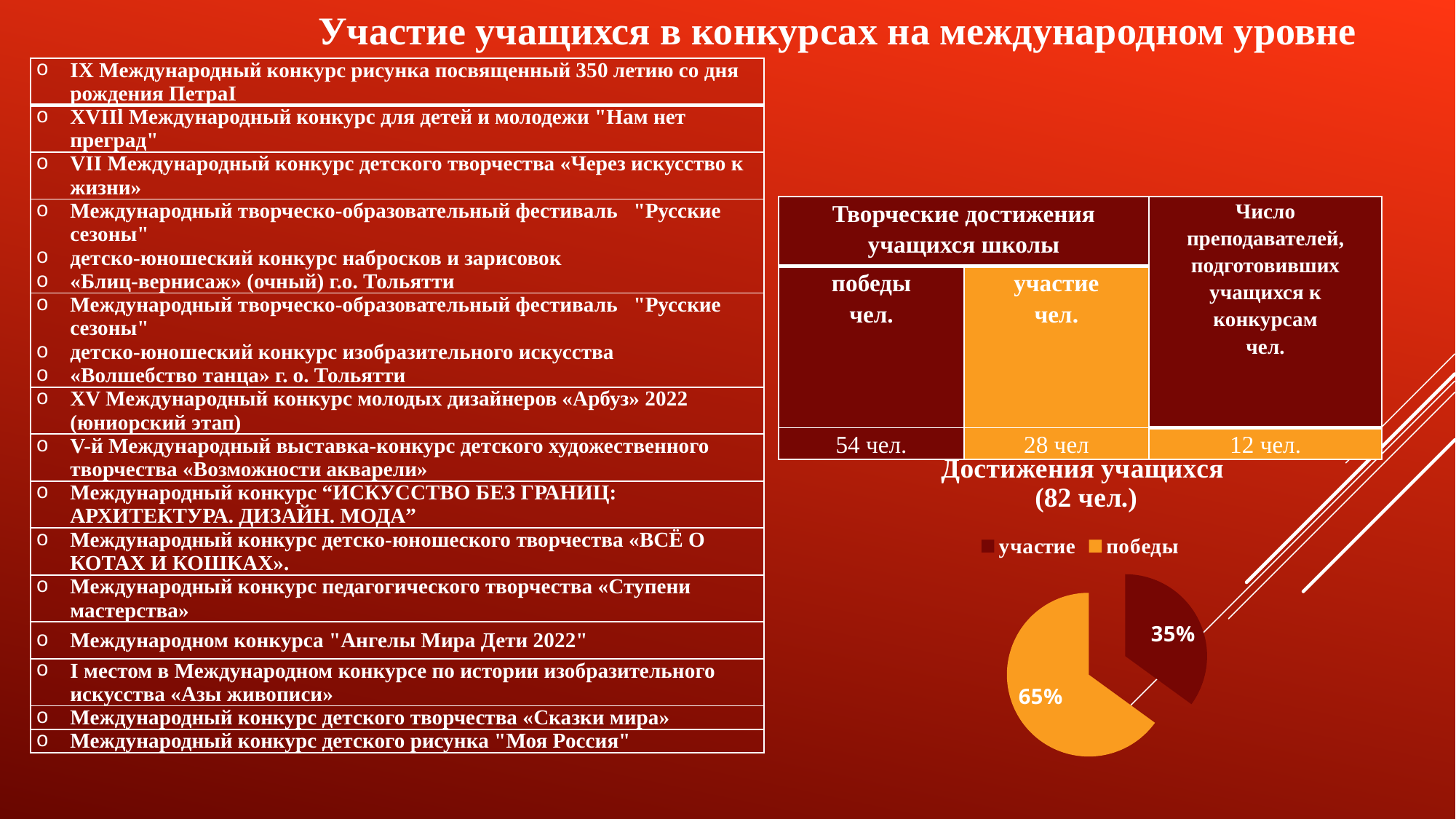
In the pie chart "Достижения учащихся (82 чел.)", what is the difference in percentage points between the "победы" and "участие" slices? 30% What kind of chart is shown under the title "Достижения учащихся (82 чел.)"? pie chart How many entries does the legend of the pie chart "Достижения учащихся (82 чел.)" list? 2 In the pie chart "Достижения учащихся (82 чел.)", which slice is the largest? победы In the pie chart "Достижения учащихся (82 чел.)", which is larger: the "участие" slice or the "победы" slice? победы In the pie chart "Достижения учащихся (82 чел.)", which slice is the smallest? участие In the pie chart "Достижения учащихся (82 чел.)", what share is labelled for the "победы" slice? 65% How many slices does the pie chart "Достижения учащихся (82 чел.)" have? 2 What is the title of the pie chart on the slide? Достижения учащихся (82 чел.) In the pie chart "Достижения учащихся (82 чел.)", what share is labelled for the "участие" slice? 35% In the pie chart "Достижения учащихся (82 чел.)", what colour is the "победы" slice? orange